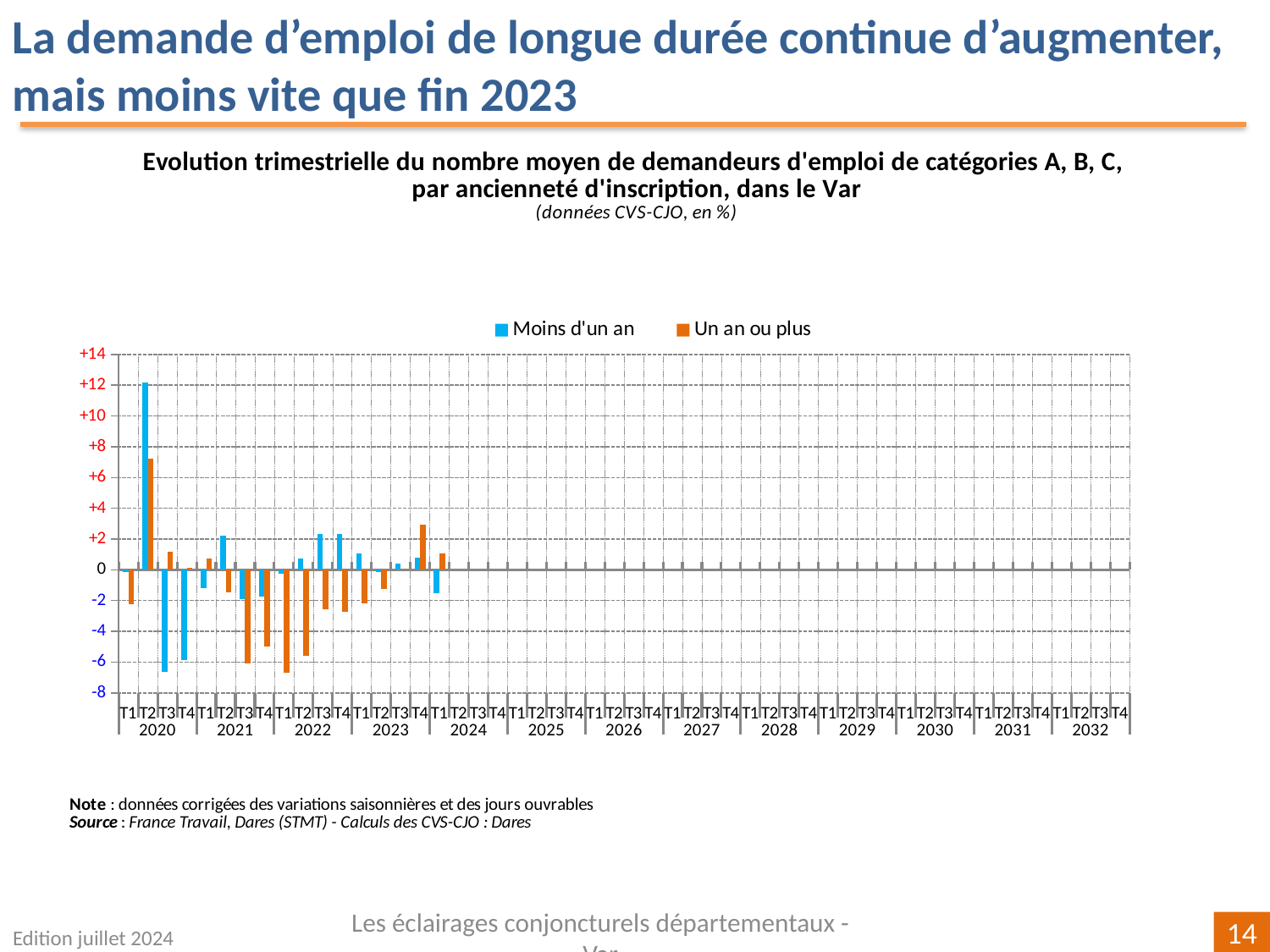
Which colour represents the series 'Un an ou plus'? orange What kind of chart is shown on the slide? bar chart In which quarter does the series 'Un an ou plus' reach its highest value? T2 2020 In which quarter does the series 'Moins d'un an' reach its highest value? T2 2020 In which quarter does the series 'Moins d'un an' reach its lowest value? T3 2020 Is the value for 'Un an ou plus' in T2 2020 greater or less than +6? greater Is the value for 'Moins d'un an' in T2 2020 greater or less than +10? greater In T3 2021, which series has the larger value, 'Moins d'un an' or 'Un an ou plus'? Moins d'un an What are the two series named in the legend? Moins d'un an; Un an ou plus In T4 2023, which series has the larger value, 'Moins d'un an' or 'Un an ou plus'? Un an ou plus Is the value for 'Un an ou plus' in T1 2022 greater or less than -4? less How many series does the legend list? 2